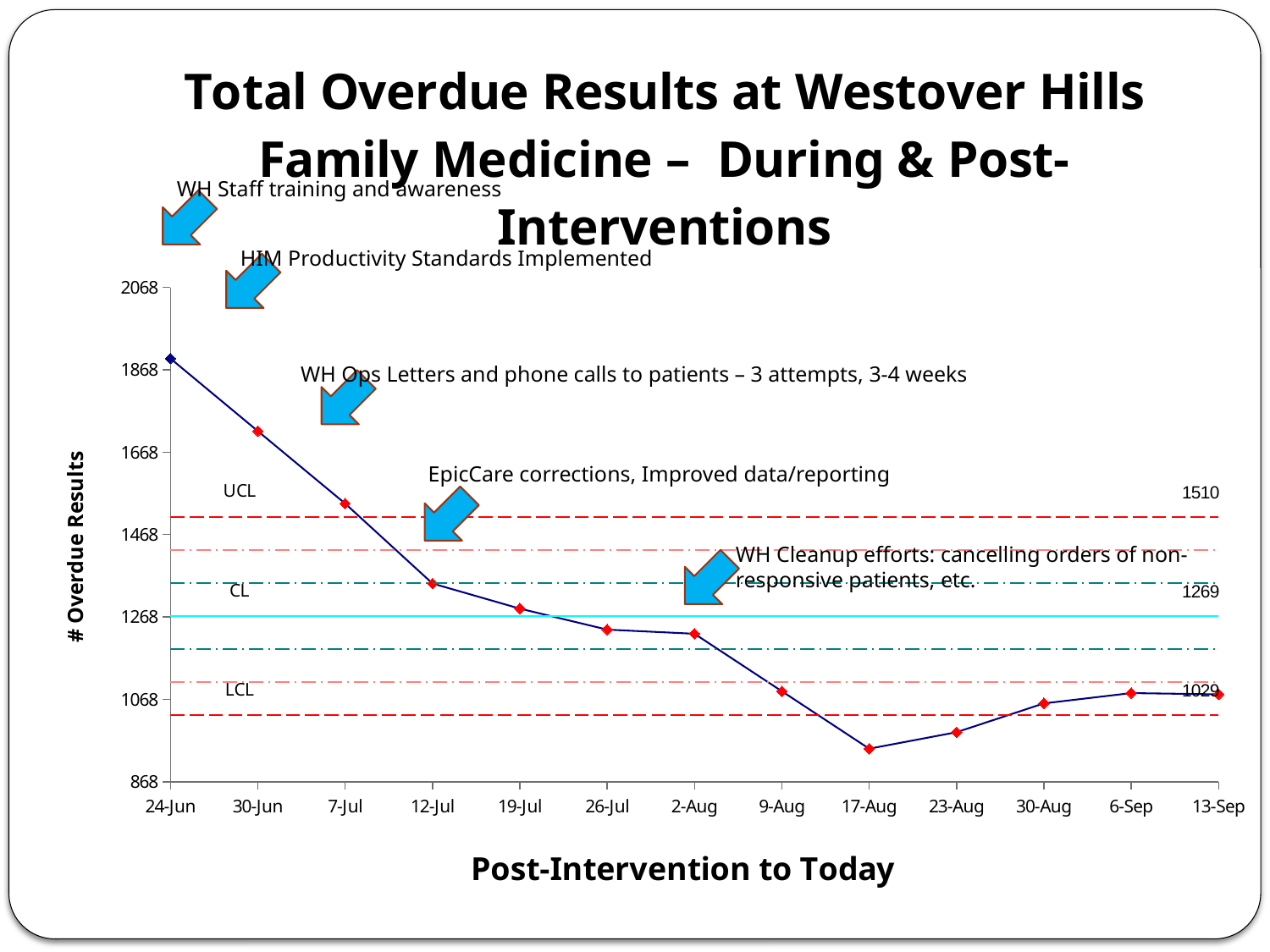
Which date has more overdue results, 30-Jun or 26-Jul? 30-Jun Which date has the highest number of overdue results? 24-Jun Is the value for 17-Aug greater or less than 1068? less Is the value for 23-Aug greater or less than 1068? less What value is labelled for the UCL line? 1510 What is the label of the y axis? # Overdue Results Is the value for 24-Jun greater or less than 1868? greater Do the overdue results rise or fall from 24-Jun to 17-Aug? fall What kind of chart is shown on the slide? line chart Which date has the lowest number of overdue results? 17-Aug How many data points are plotted on the line? 13